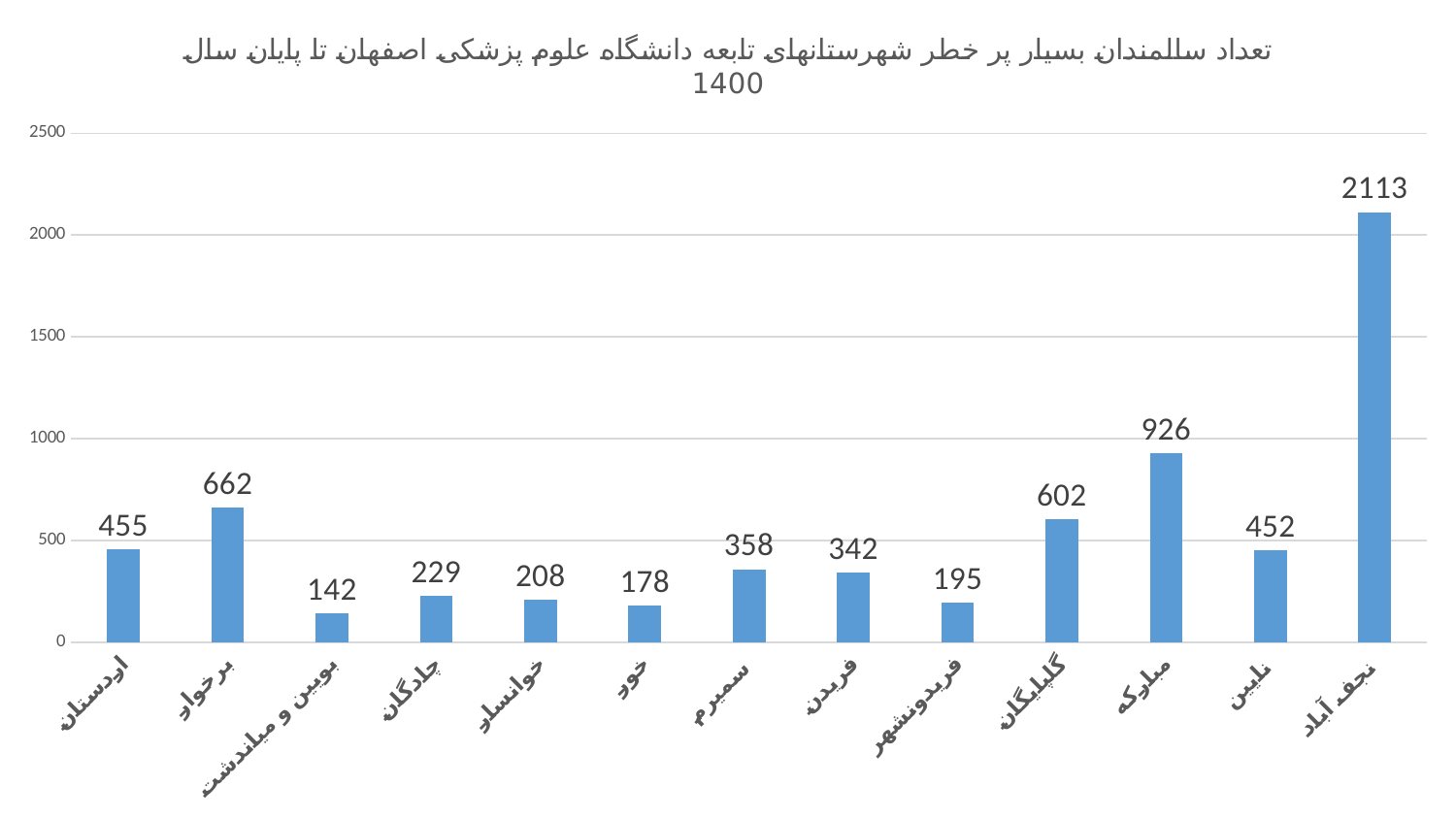
What is the maximum value shown on the vertical axis? 2500 What kind of chart is shown on the slide? bar chart What is the value for مبارکه? 926 What is the difference between the values for برخوار and گلپایگان? 60 What is the value for خوانسار? 208 What is the value for نجف آباد? 2113 Which category has the highest value? نجف آباد Is the value for مبارکه greater or less than 1000? less What is the difference between the values for نجف آباد and مبارکه? 1187 Which is larger, the value for سمیرم or the value for فریدن? سمیرم Which category has the lowest value? بویین و میاندشت How many categories are shown on the x axis? 13